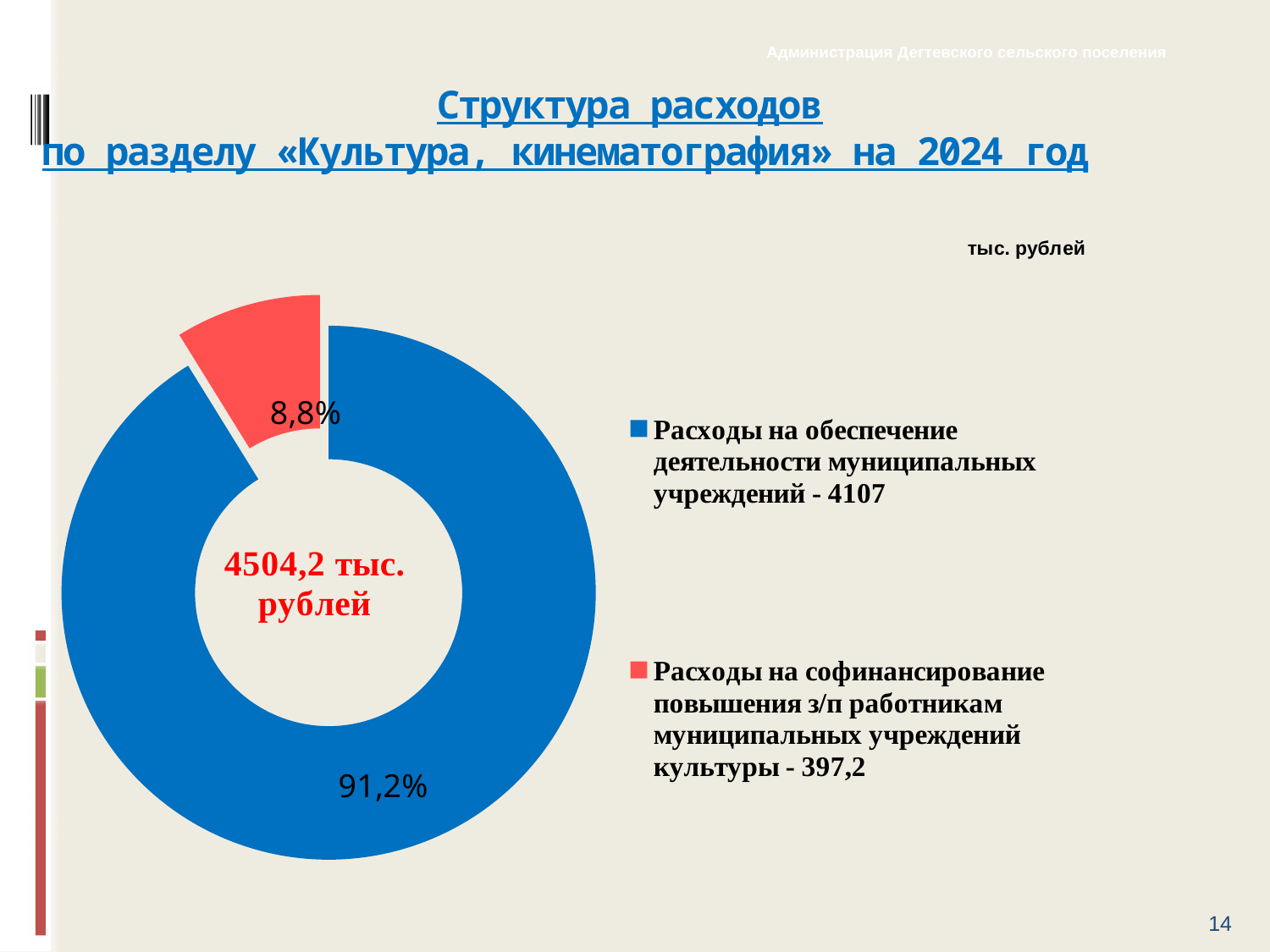
What value (in тыс. рублей) is given in the legend for 'Расходы на софинансирование повышения з/п работникам муниципальных учреждений культуры'? 397,2 What value (in тыс. рублей) is given in the legend for 'Расходы на обеспечение деятельности муниципальных учреждений'? 4107 Which category has the smallest share of the chart? Расходы на софинансирование повышения з/п работникам муниципальных учреждений культуры Which category has the largest share of the chart? Расходы на обеспечение деятельности муниципальных учреждений What total amount is shown in the centre of the doughnut chart? 4504,2 тыс. рублей What colour is the slice representing 8,8% of the chart? Red What kind of chart is shown on the slide? Doughnut (pie) chart What is the difference in percentage points between the two slices of the chart? 82,4 Which is larger: the value for 'Расходы на обеспечение деятельности муниципальных учреждений' or for 'Расходы на софинансирование повышения з/п работникам муниципальных учреждений культуры'? Расходы на обеспечение деятельности муниципальных учреждений What share of the chart does the slice for 'Расходы на софинансирование повышения з/п работникам муниципальных учреждений культуры' represent? 8,8% What share of the chart does the slice for 'Расходы на обеспечение деятельности муниципальных учреждений' represent? 91,2% How many categories does the chart show? 2